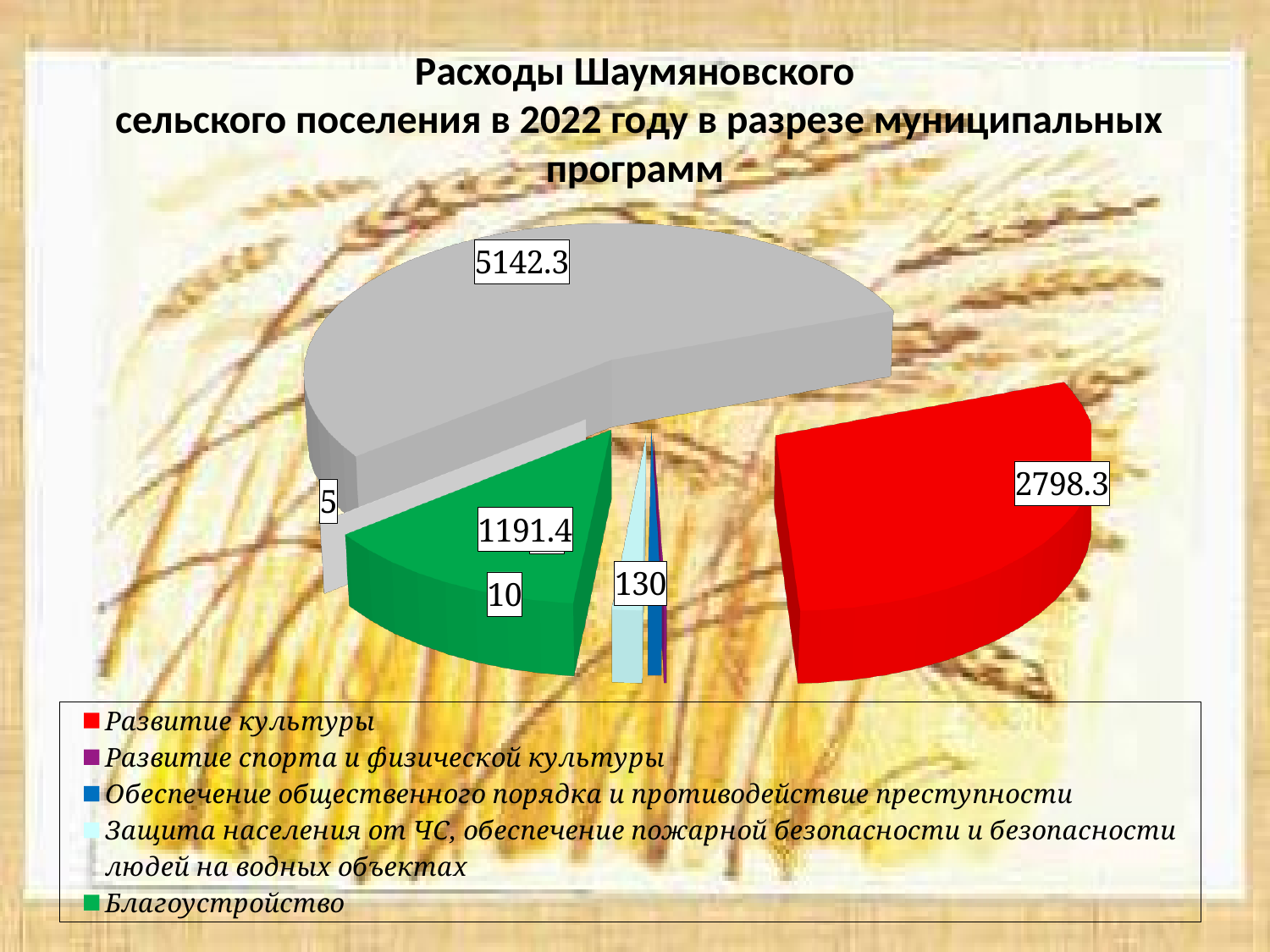
What is the largest value printed on the chart? 5142.3 What kind of chart is shown on the slide? pie chart How many entries does the legend list? 5 What is the difference between the value for Развитие культуры and the value for Благоустройство? 1606.9 What colour represents Благоустройство in the legend? green What is the value shown for Благоустройство? 1191.4 How many data labels are printed on the pie chart? 6 Which is larger, the value for Развитие культуры or the value for Благоустройство? Развитие культуры What is the title of the chart? Расходы Шаумяновского сельского поселения в 2022 году в разрезе муниципальных программ What is the value shown for Развитие культуры? 2798.3 What is the smallest value printed on the chart? 5 What is the value shown for Защита населения от ЧС, обеспечение пожарной безопасности и безопасности людей на водных объектах? 130